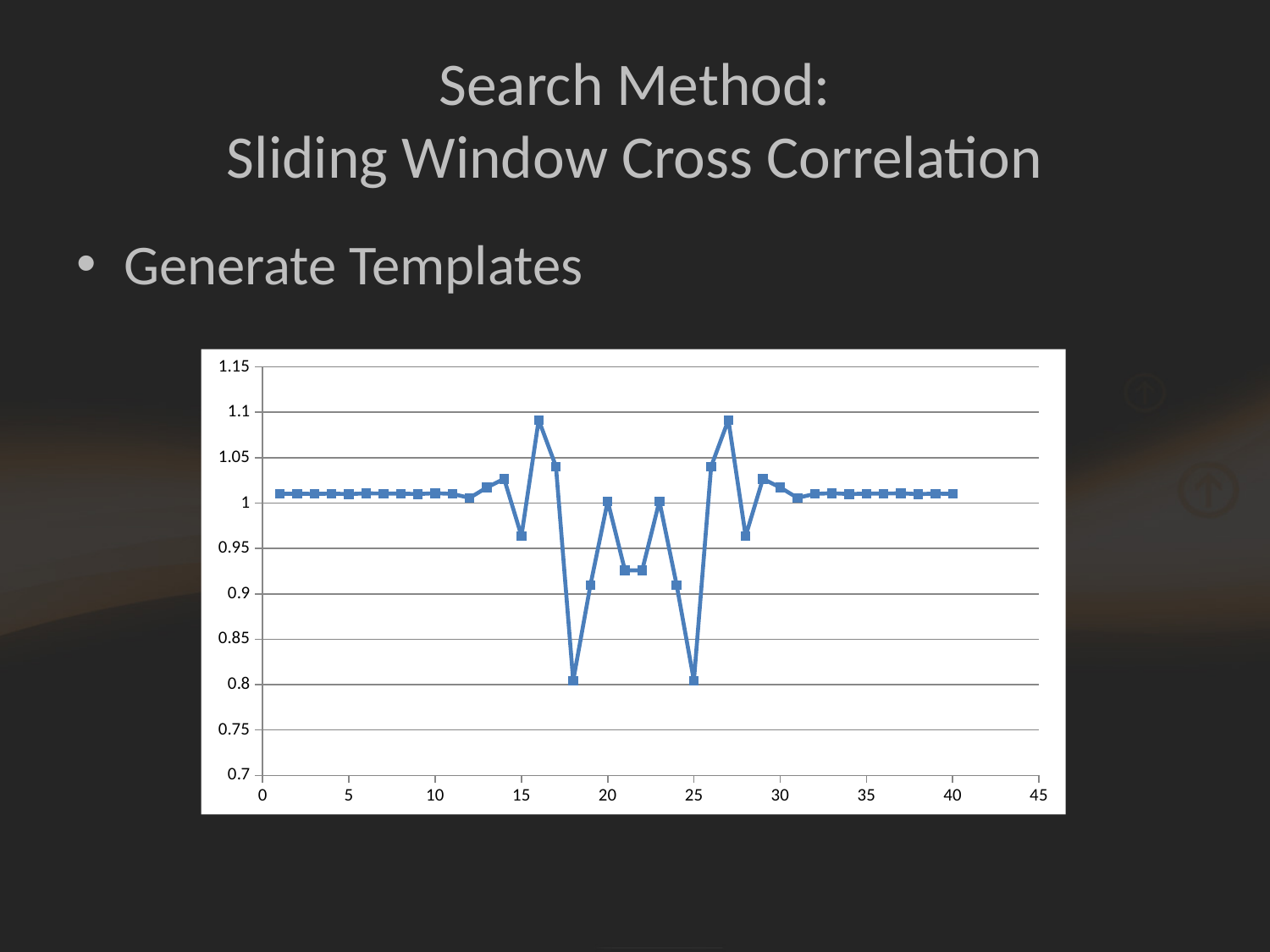
What is the highest value shown on the chart's vertical axis? 1.15 Do the values rise or fall between x = 17 and x = 18? fall Is the value at x = 25 greater or less than 0.9? less Do the values rise or fall between x = 25 and x = 27? rise What kind of chart is shown on the slide? line chart Is the value at x = 18 greater or less than 0.85? less Is the value at x = 21 greater or less than 0.95? less Which has the larger value, the point at x = 27 or the point at x = 28? x = 27 How many data points are plotted on the chart? 40 Which has the larger value, the point at x = 18 or the point at x = 20? x = 20